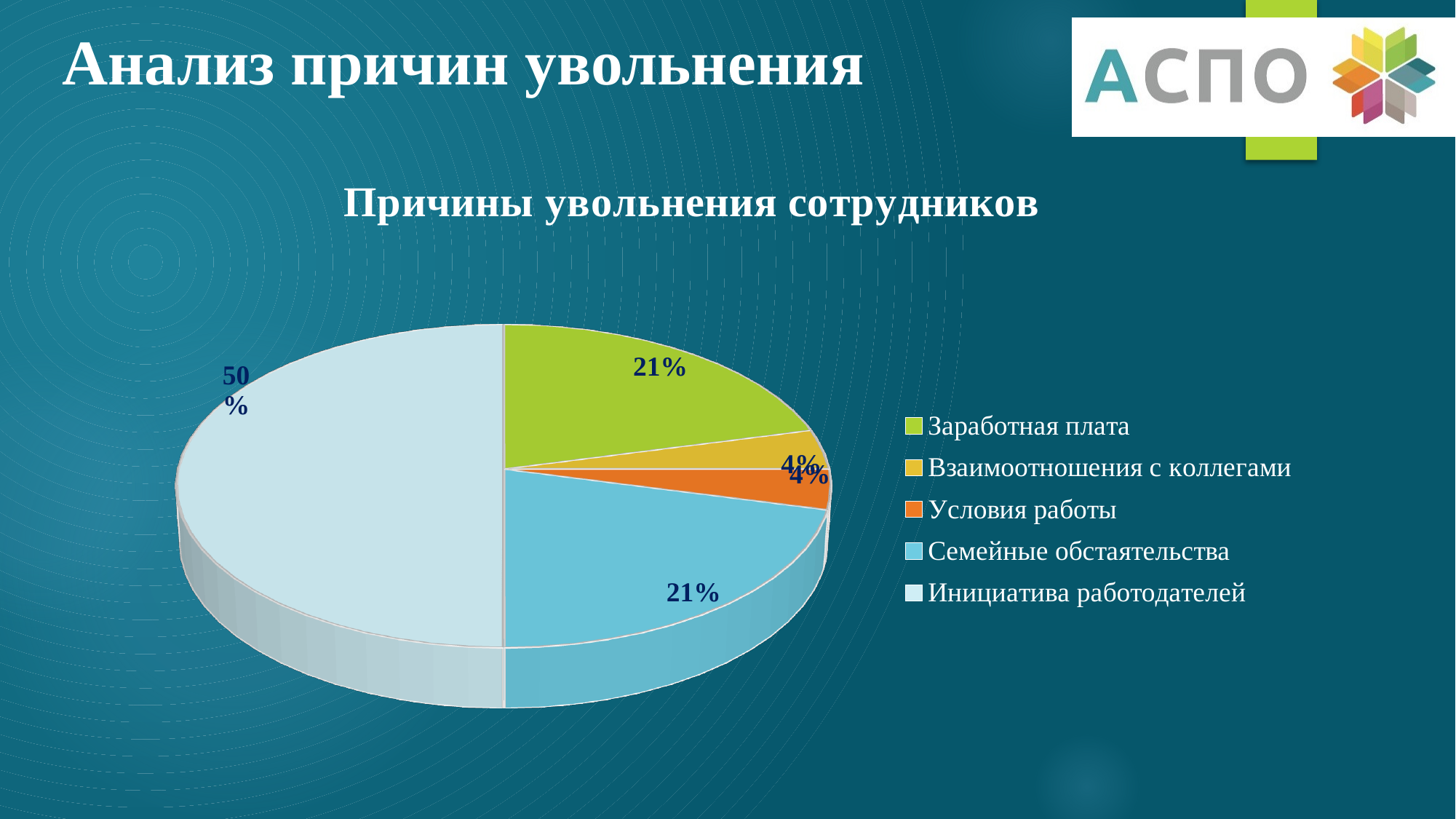
What is the combined share of "Взаимоотношения с коллегами" and "Условия работы"? 8% What is the value shown for "Условия работы"? 4% Which is larger: the share for "Заработная плата" or the share for "Взаимоотношения с коллегами"? Заработная плата Which category has the largest slice of the pie? Инициатива работодателей What is the value shown for "Заработная плата"? 21% What share of the pie does "Инициатива работодателей" take? 50% What is the difference between the share for "Инициатива работодателей" and the share for "Заработная плата"? 29% What is the value shown for "Семейные обстаятельства"? 21% How many categories does the legend of the pie chart list? 5 What is the title of the chart? Причины увольнения сотрудников What kind of chart is shown on the slide? Pie chart Which legend entry is shown in orange? Условия работы